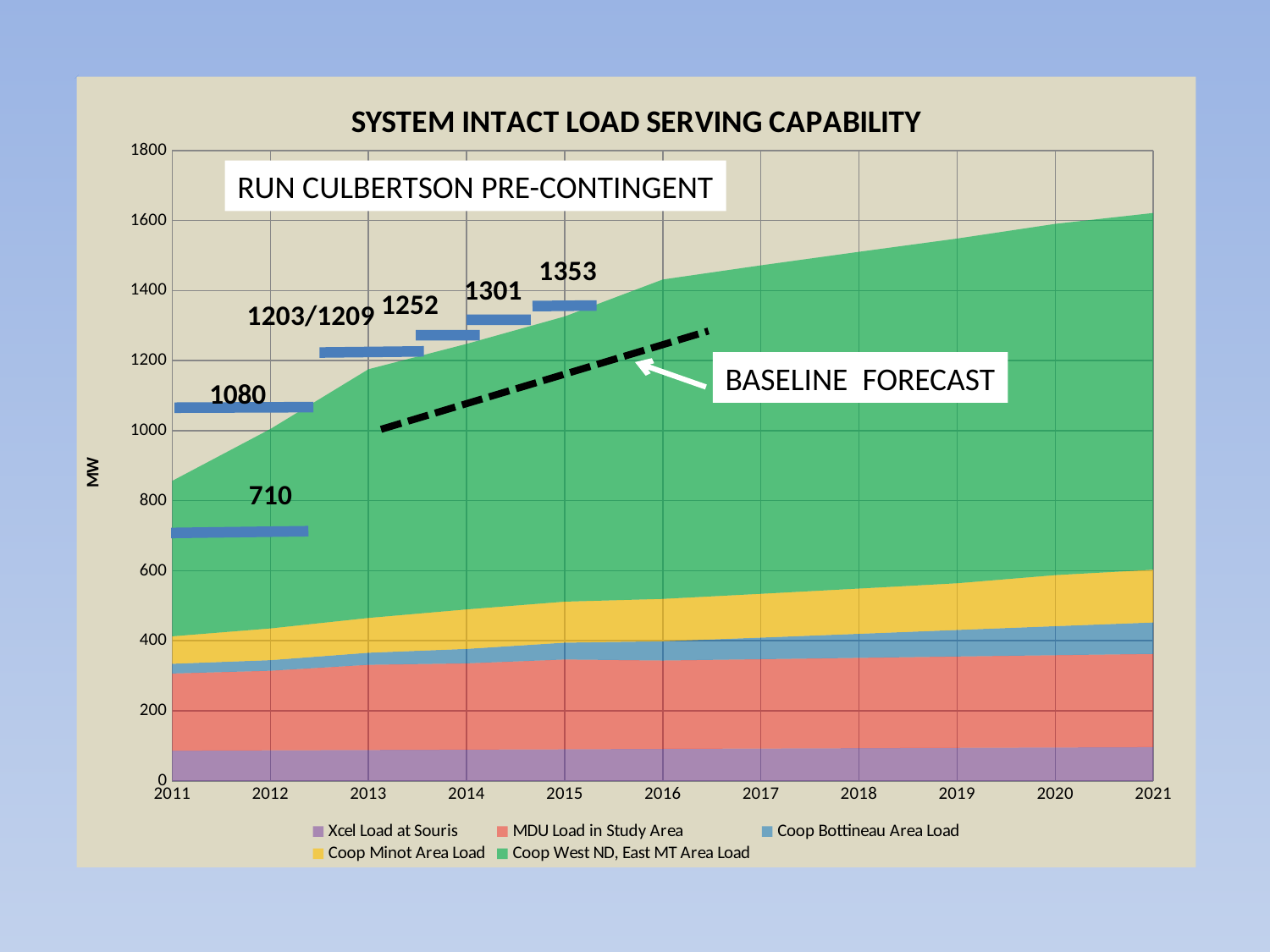
What is the lowest value printed on the blue capability bars? 710 What kind of chart is shown on the slide? stacked area chart How many years are shown along the x axis? 11 What is the label on the y axis? MW Is the Xcel Load at Souris in 2021 greater or less than 200 MW? less What is the highest value printed on the blue capability bars? 1353 Does the total stacked load rise or fall from 2011 to 2021? rises What is the difference between the blue bar labelled 1080 and the one labelled 710? 370 Is the total stacked load in 2011 greater or less than 1000 MW? less What is the difference between the blue bar labelled 1353 and the one labelled 1301? 52 What is the title of the chart? SYSTEM INTACT LOAD SERVING CAPABILITY How many series does the legend list? 5